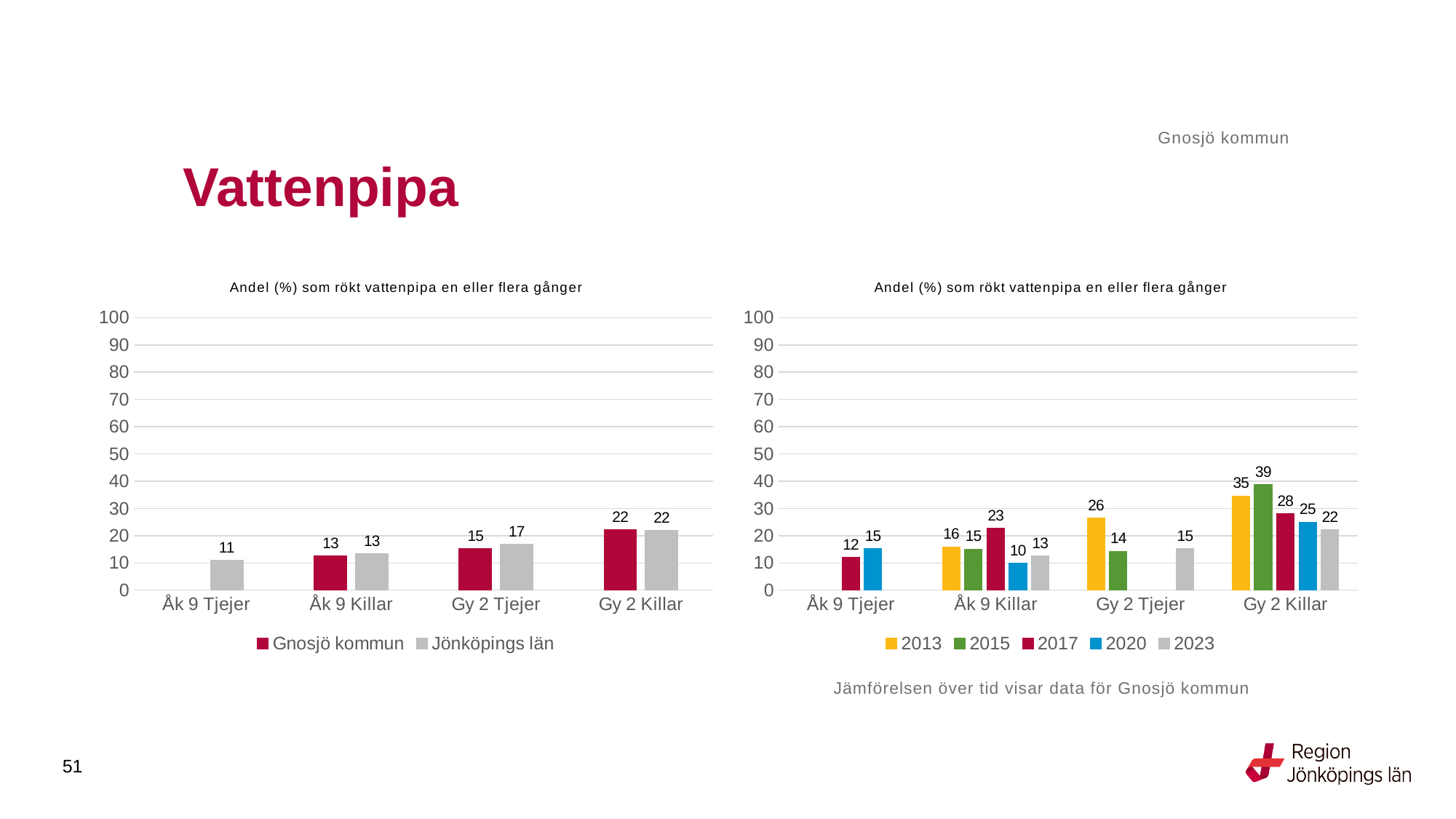
In the left chart, what is the difference between Jönköpings län and Gnosjö kommun for Gy 2 Tjejer? 2 In the right chart, which year has the highest value for Gy 2 Killar? 2015 In the right chart, what is the value for 2013 for Gy 2 Tjejer? 26 In the left chart, what is the value for Jönköpings län for Gy 2 Tjejer? 17 In the right chart, what is the value for 2017 for Åk 9 Killar? 23 In the left chart, which category has the highest value for Jönköpings län? Gy 2 Killar What type of chart is the right chart? Bar chart In the left chart, what is the value for Gnosjö kommun for Gy 2 Killar? 22 In the right chart, which year has the lowest value for Åk 9 Killar? 2020 In the right chart, how many series does the legend list? 5 In the left chart, how many series does the legend list? 2 In the right chart, what is the difference between the 2015 and 2023 values for Gy 2 Killar? 17